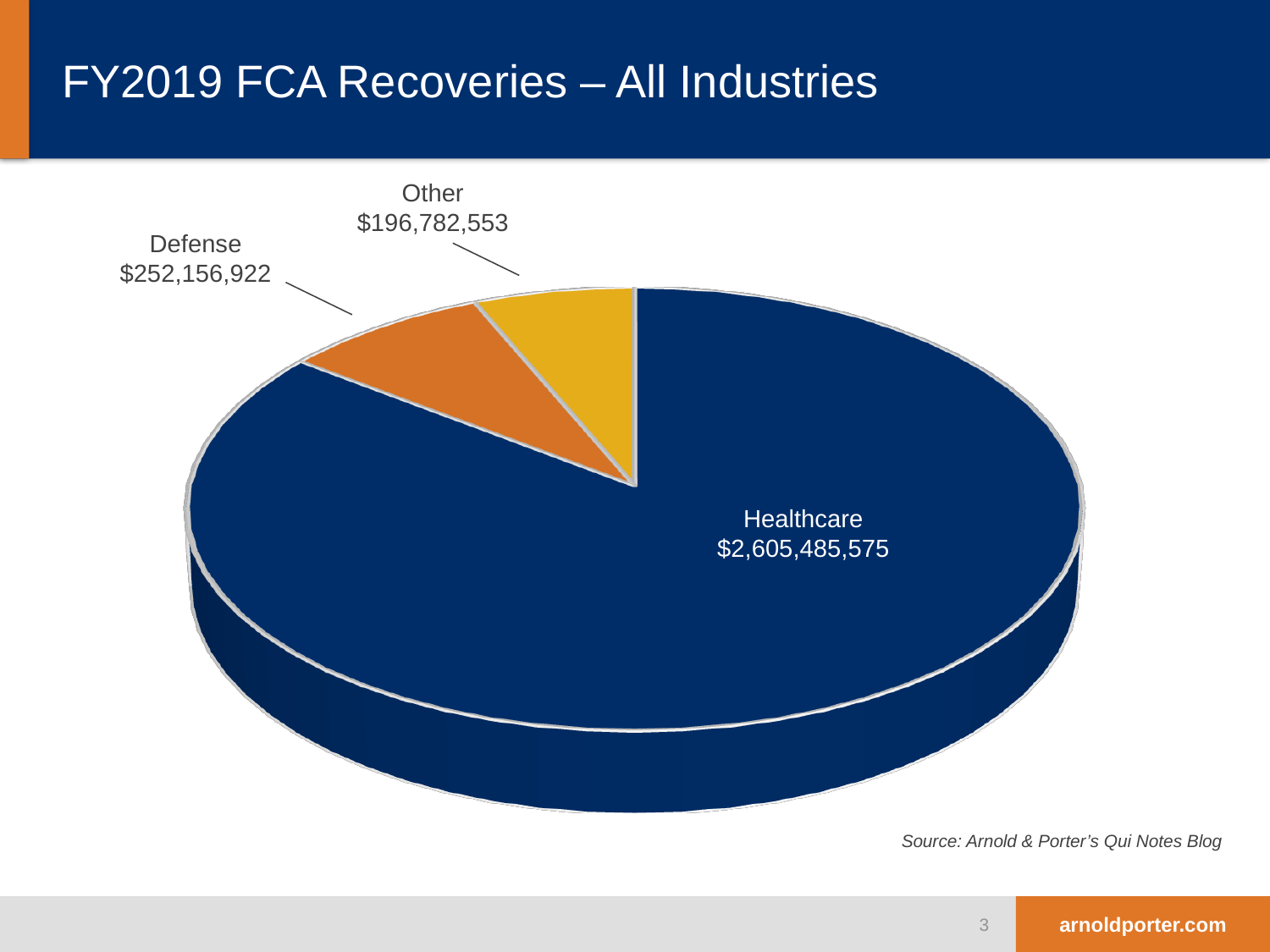
Which is larger, the recoveries for Defense or for Other? Defense How many categories are shown in the pie chart? 3 What is the FY2019 FCA recovery value for Other? $196,782,553 What type of chart is shown on the slide? Pie chart What is the total of all three recovery values shown in the chart? $3,054,425,050 What is the FY2019 FCA recovery value for Healthcare? $2,605,485,575 Which category has the smallest FCA recoveries in the chart? Other Which industry has the largest FCA recoveries in the chart? Healthcare What is the FY2019 FCA recovery value for Defense? $252,156,922 What is the difference between the Healthcare and Defense recovery values? $2,353,328,653 What is the difference between the Defense and Other recovery values? $55,374,369 What is the title of the slide containing the chart? FY2019 FCA Recoveries – All Industries